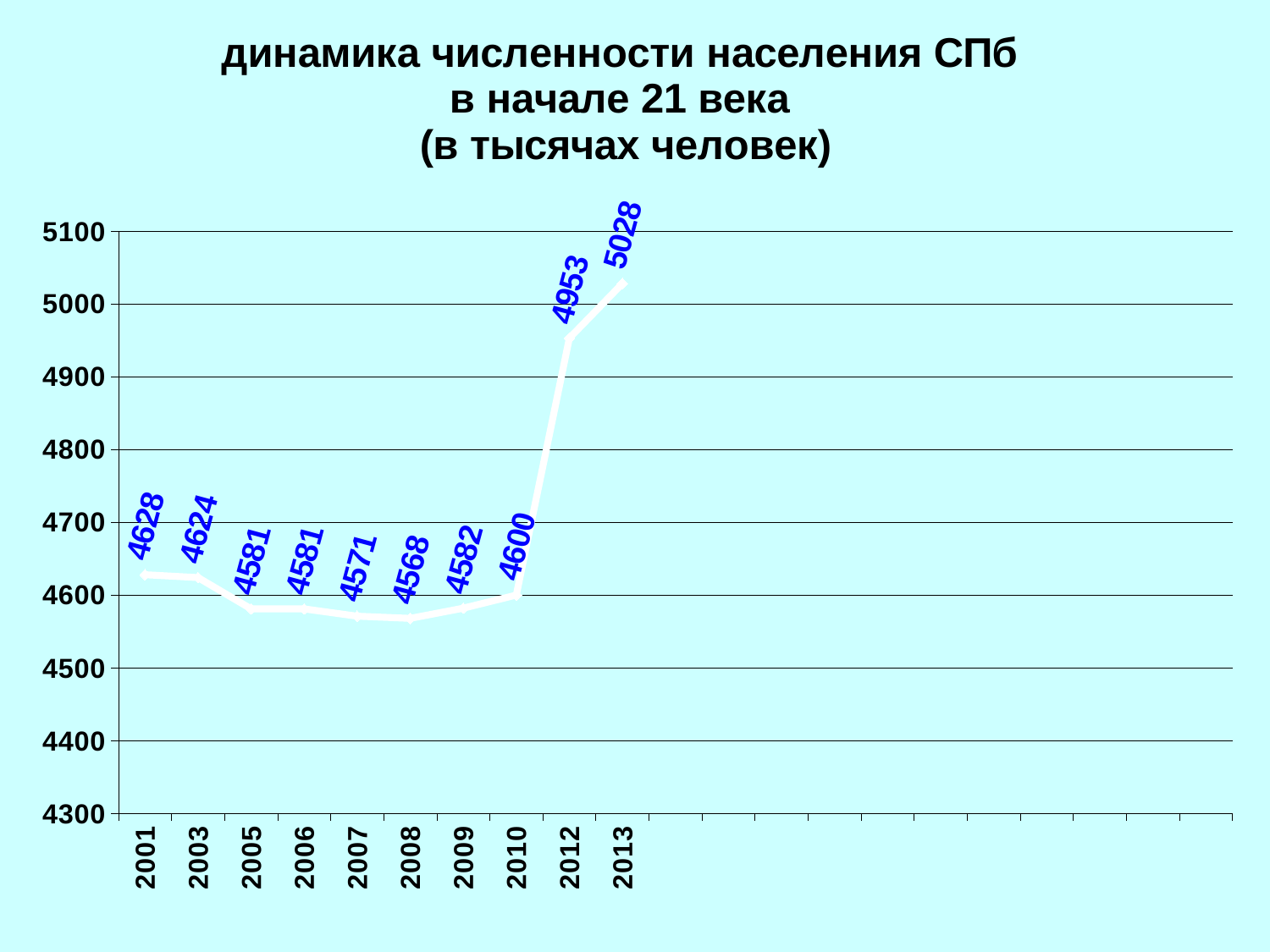
What is the population value shown for 2001? 4628 Do the values rise or fall between 2010 and 2013? rise What is the population value shown for 2008? 4568 What is the population value shown for 2013? 5028 What is the difference between the values for 2001 and 2008? 60 How many years are plotted on the chart? 10 Is the value for 2012 greater or less than 4900? greater Which year has the lowest value on the chart? 2008 What is the difference between the values for 2013 and 2012? 75 Which year has the highest value on the chart? 2013 Which is larger, the value for 2003 or the value for 2010? 2003 What kind of chart is shown on the slide? line chart